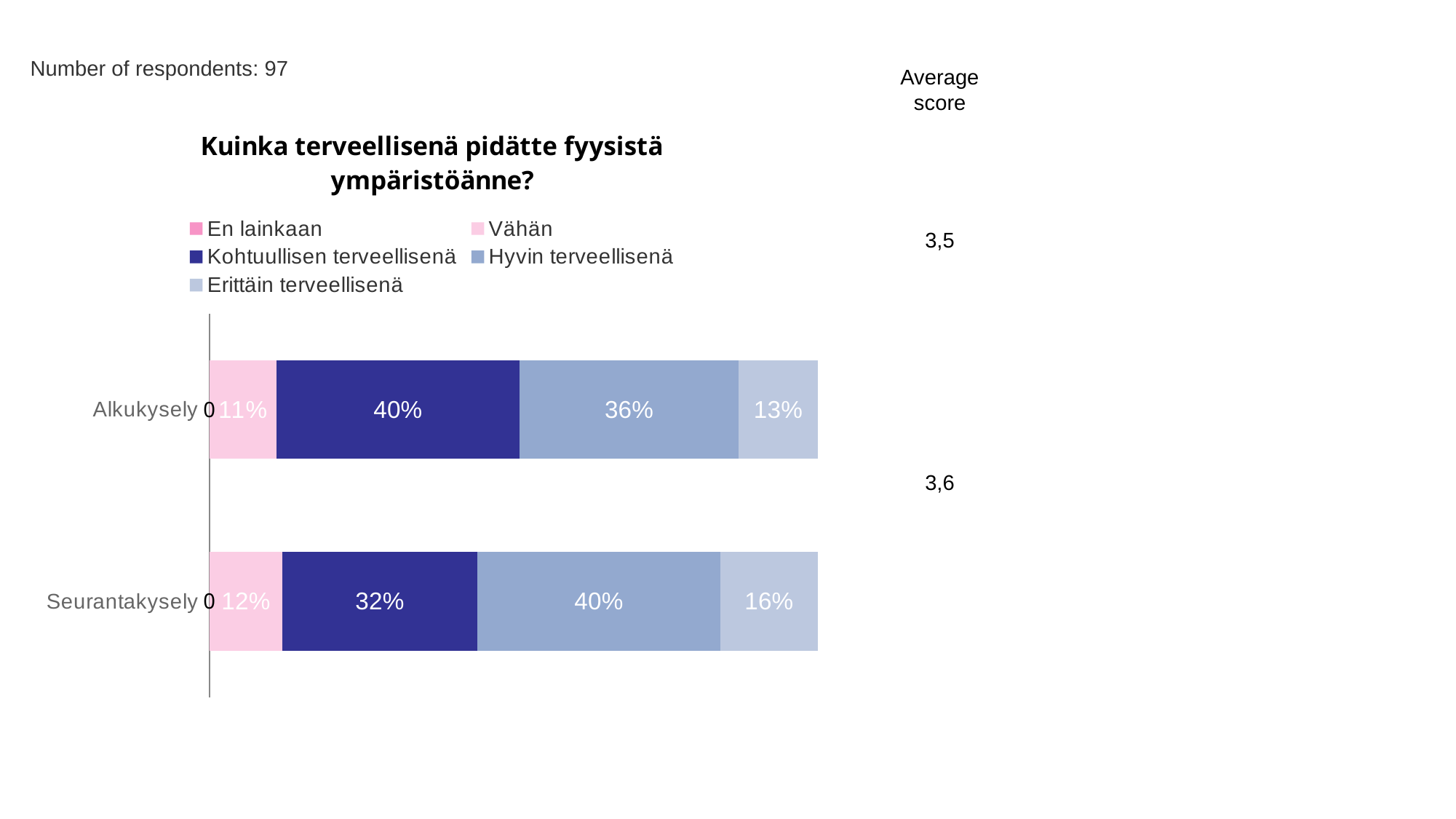
Which is larger: Erittäin terveellisenä for Alkukysely or for Seurantakysely? Seurantakysely What is the value for Erittäin terveellisenä in the Alkukysely bar? 13% What is the title of the chart? Kuinka terveellisenä pidätte fyysistä ympäristöänne? Which segment is the largest in the Seurantakysely bar? Hyvin terveellisenä What is the value for Vähän in the Seurantakysely bar? 12% What is the difference between the Kohtuullisen terveellisenä values for Alkukysely and Seurantakysely? 8% What is the value for Kohtuullisen terveellisenä in the Alkukysely bar? 40% What is the value for Hyvin terveellisenä in the Seurantakysely bar? 40% What is the value for En lainkaan in the Alkukysely bar? 0 What kind of chart is shown on the slide? stacked bar chart How many categories are plotted on the chart? 2 How many series does the legend list? 5